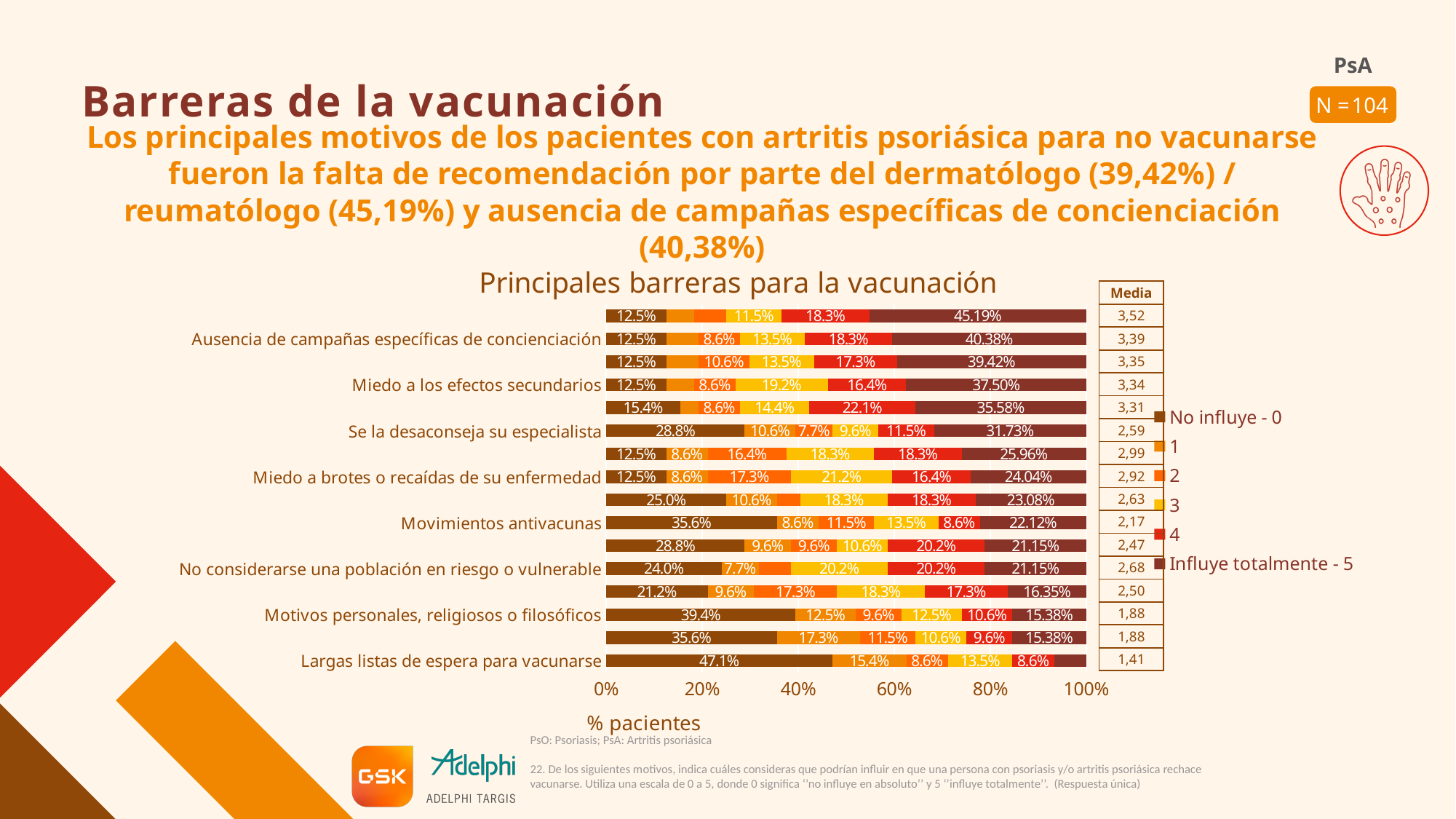
What is the 'No influye - 0' value for 'Movimientos antivacunas'? 35.6% How many series does the legend list? 6 Which has a larger 'Influye totalmente - 5' value: 'Miedo a los efectos secundarios' or 'Se la desaconseja su especialista'? Miedo a los efectos secundarios What is the 'Media' value shown for 'Ausencia de campañas específicas de concienciación'? 3,39 What kind of chart is shown on the slide? Stacked bar chart What is the title of the x axis? % pacientes What is the 'Influye totalmente - 5' value for 'Ausencia de campañas específicas de concienciación'? 40.38% What is the 'No influye - 0' value for 'Largas listas de espera para vacunarse'? 47.1% What is the 'Influye totalmente - 5' value for 'Miedo a los efectos secundarios'? 37.50% Which category has the highest 'No influye - 0' share? Largas listas de espera para vacunarse What is the 'Media' value shown for 'Largas listas de espera para vacunarse'? 1,41 What is the difference between the 'Influye totalmente - 5' values for 'Ausencia de campañas específicas de concienciación' and 'Miedo a los efectos secundarios'? 2.88 percentage points